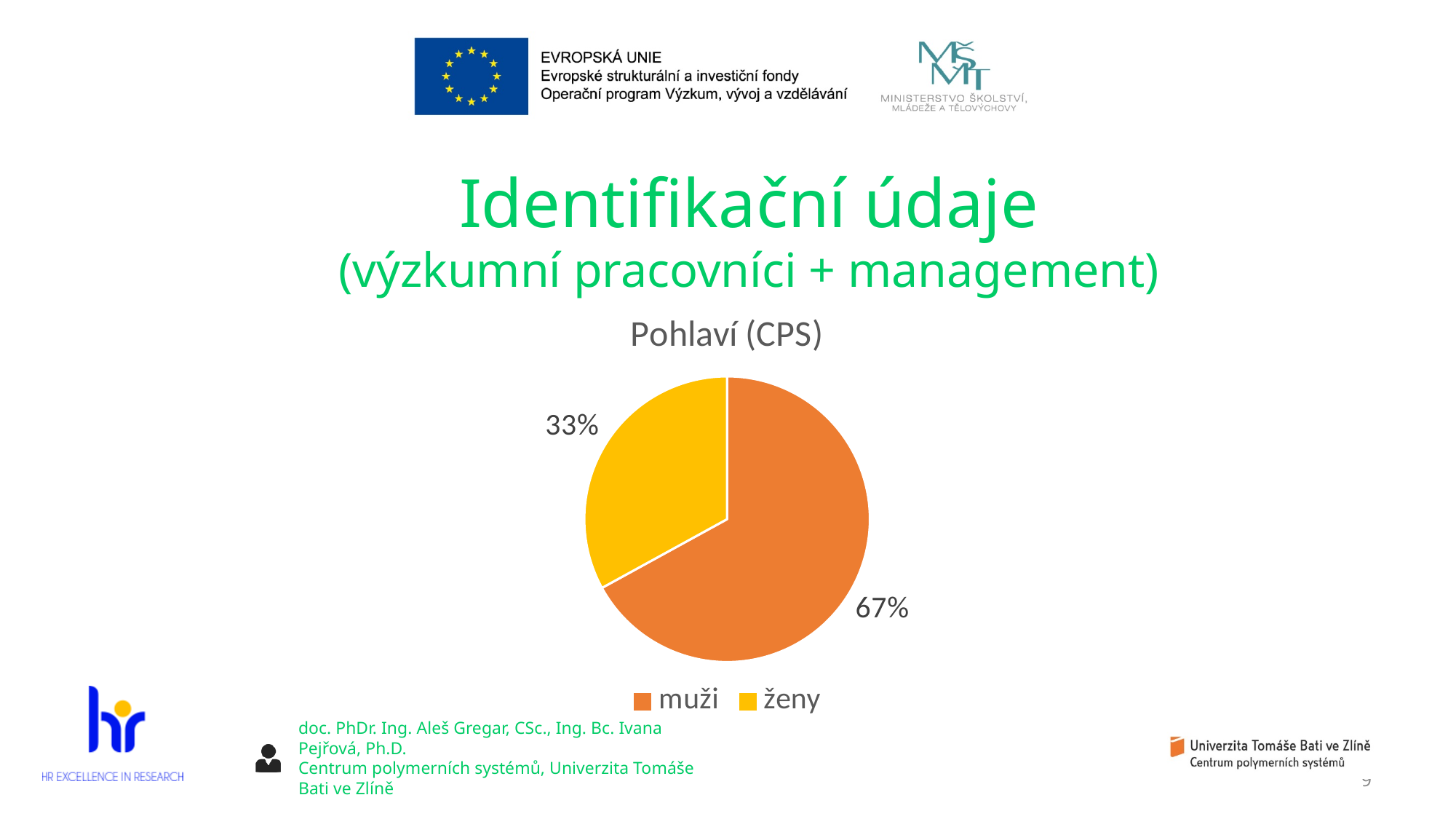
What kind of chart is shown on the slide? pie chart What share of the pie does the "muži" slice represent? 67% What is the difference in percentage points between the "muži" and "ženy" slices? 34 What colour is the "ženy" slice in the pie chart? yellow Which slice is larger, "muži" or "ženy"? muži Which category has the largest slice of the pie? muži What share of the pie does the "ženy" slice represent? 33% Which category has the smallest slice of the pie? ženy How many categories does the pie chart show? 2 What is the title of the chart? Pohlaví (CPS)